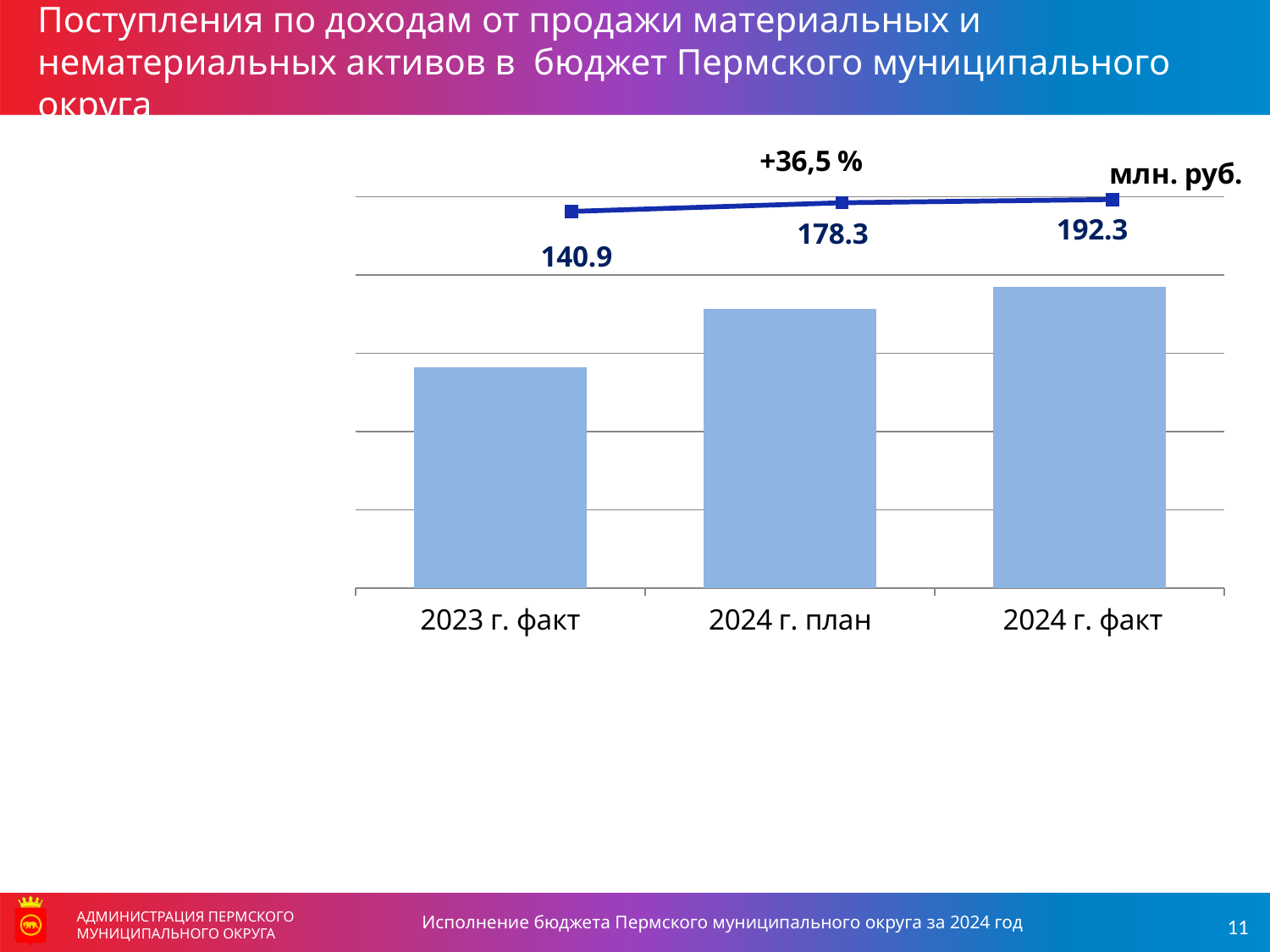
What is the difference between the values for 2024 г. факт and 2023 г. факт? 51.4 Which category has the lowest value? 2023 г. факт What is the difference between the values for 2024 г. факт and 2024 г. план? 14.0 What kind of chart is shown on the slide? a bar chart combined with a line chart What is the value for 2024 г. план? 178.3 Which is larger, the value for 2024 г. план or the value for 2023 г. факт? 2024 г. план What unit of measurement is indicated on the chart? млн. руб. How many categories are shown on the x axis? 3 What is the value for 2023 г. факт? 140.9 Which category has the highest value? 2024 г. факт Do the values rise or fall from left to right along the x axis? rise What is the value for 2024 г. факт? 192.3